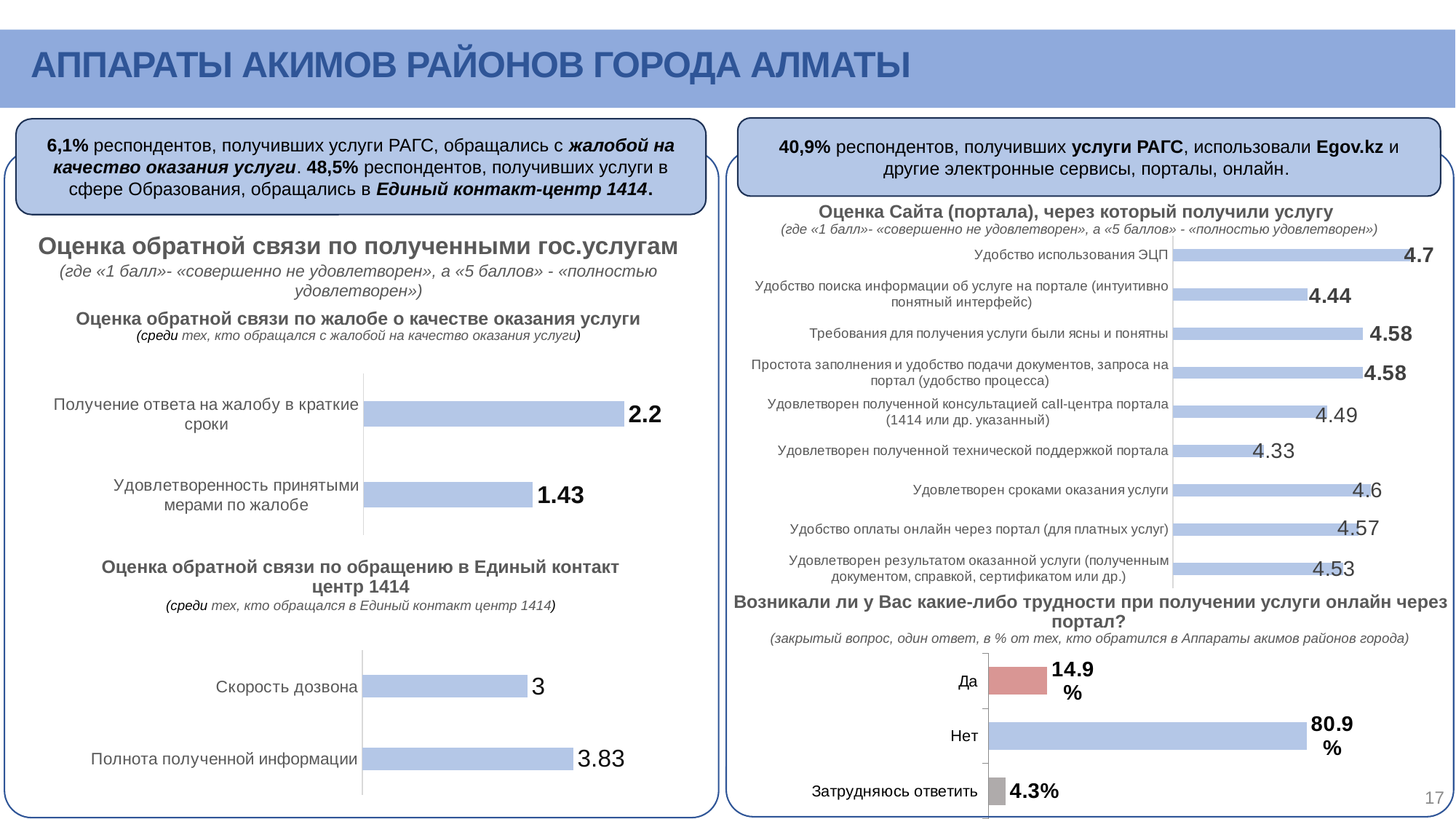
In the chart 'Оценка Сайта (портала), через который получили услугу', which category has the highest value? Удобство использования ЭЦП What type of chart is 'Возникали ли у Вас какие-либо трудности при получении услуги онлайн через портал?'? Bar chart In the chart 'Оценка обратной связи по жалобе о качестве оказания услуги', what is the value for 'Удовлетворенность принятыми мерами по жалобе'? 1.43 In the chart 'Оценка обратной связи по обращению в Единый контакт центр 1414', what is the value for 'Полнота полученной информации'? 3.83 In the chart 'Оценка обратной связи по обращению в Единый контакт центр 1414', what is the difference between 'Полнота полученной информации' and 'Скорость дозвона'? 0.83 How many categories are shown in the chart 'Оценка Сайта (портала), через который получили услугу'? 9 In the chart 'Возникали ли у Вас какие-либо трудности при получении услуги онлайн через портал?', what is the difference between 'Да' and 'Затрудняюсь ответить'? 10.6% In the chart 'Оценка обратной связи по жалобе о качестве оказания услуги', what is the value for 'Получение ответа на жалобу в краткие сроки'? 2.2 In the chart 'Оценка обратной связи по обращению в Единый контакт центр 1414', which category has the lower value? Скорость дозвона In the chart 'Оценка Сайта (портала), через который получили услугу', which category has the lowest value? Удовлетворен полученной технической поддержкой портала In the chart 'Оценка Сайта (портала), через который получили услугу', what is the value for 'Удобство оплаты онлайн через портал (для платных услуг)'? 4.57 In the chart 'Возникали ли у Вас какие-либо трудности при получении услуги онлайн через портал?', what is the value for 'Нет'? 80.9%